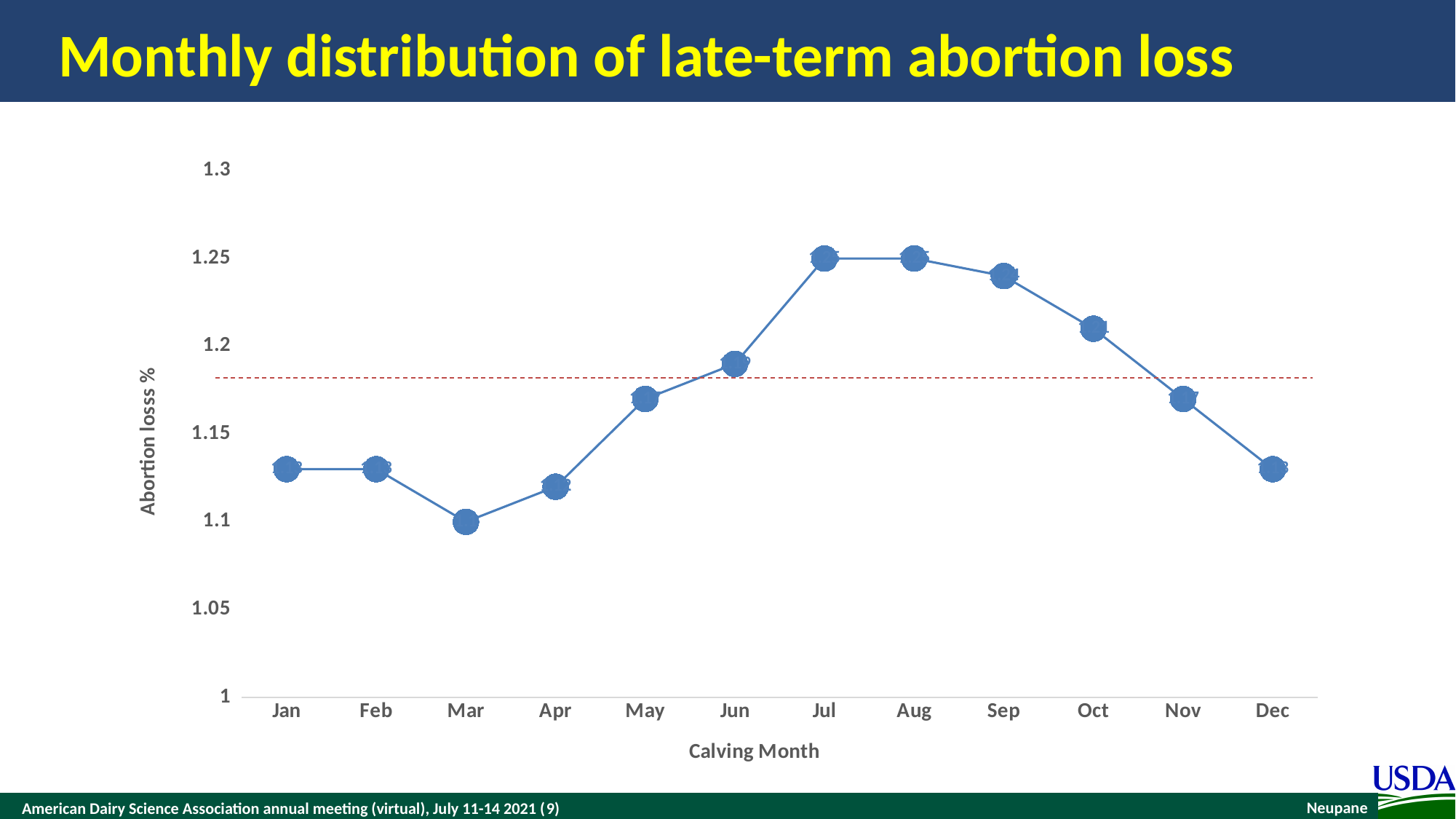
Which calving month has the lowest abortion loss? Mar Which has a higher abortion loss, Apr or May? May Do the values rise or fall from Mar to Jul? rise What is the abortion loss % for Mar? 1.1 Which has a higher abortion loss, Oct or Nov? Oct How many calving months are plotted on the x axis? 12 What is the abortion loss % for Jul? 1.25 What kind of chart is shown on the slide? line chart Is the value for Dec greater or less than 1.15? less What is the title of the x axis? Calving Month Is the value for Jun greater or less than 1.15? greater